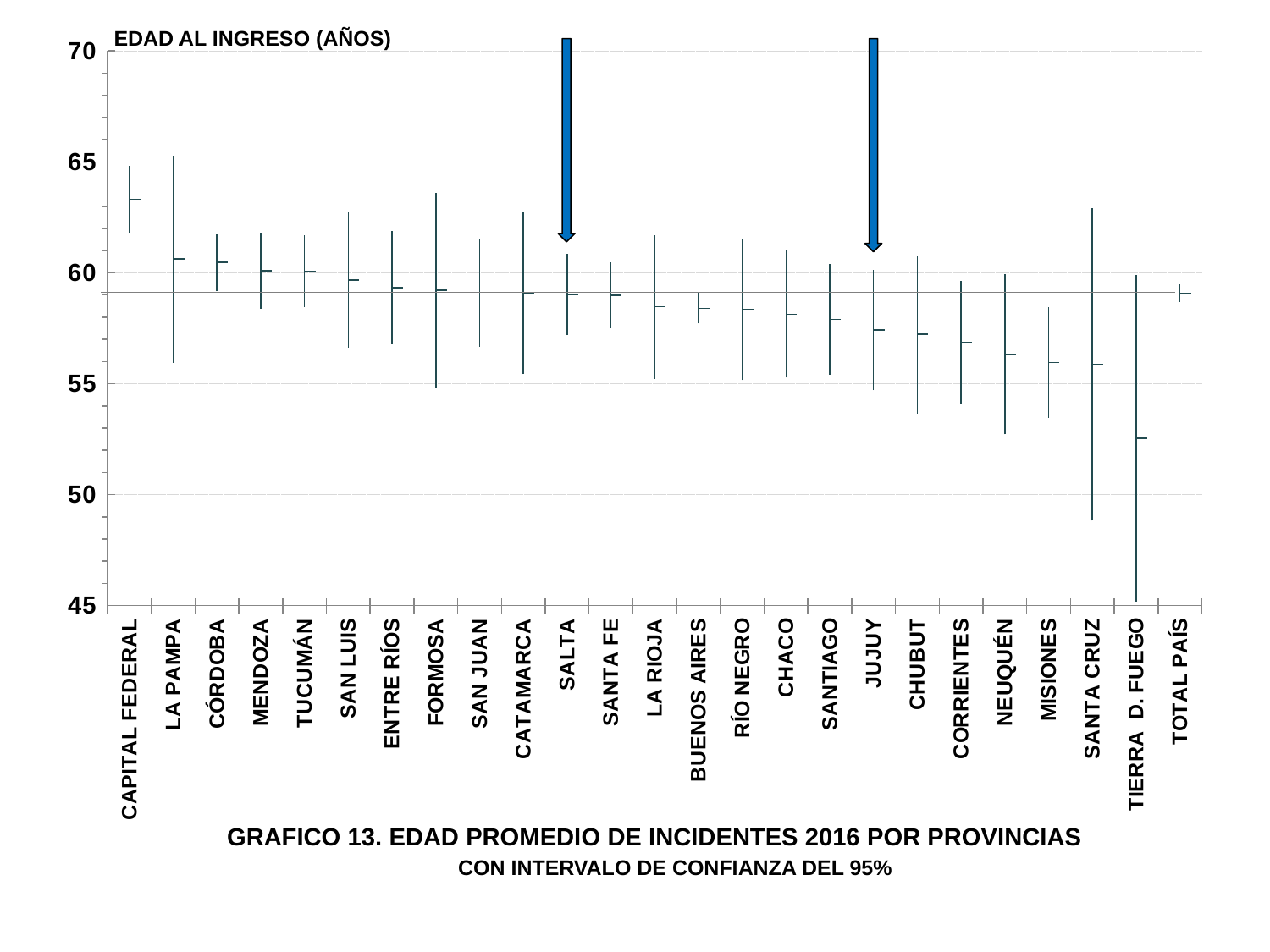
Is the average age for TIERRA D. FUEGO greater or less than 55? less Is the average age for CAPITAL FEDERAL greater or less than 60? greater Do the average ages generally rise or fall moving from left to right across the provinces? fall What is the title of the chart? GRAFICO 13. EDAD PROMEDIO DE INCIDENTES 2016 POR PROVINCIAS Is the average age for CHUBUT greater or less than 60? less Which has a higher average age at admission, LA PAMPA or MISIONES? LA PAMPA How many categories are shown along the x axis of the chart? 25 Which has a higher average age at admission, CAPITAL FEDERAL or TIERRA D. FUEGO? CAPITAL FEDERAL What is the label on the vertical axis of the chart? EDAD AL INGRESO (AÑOS) Which province has the highest average age at admission? CAPITAL FEDERAL Which province has the lowest average age at admission? TIERRA D. FUEGO